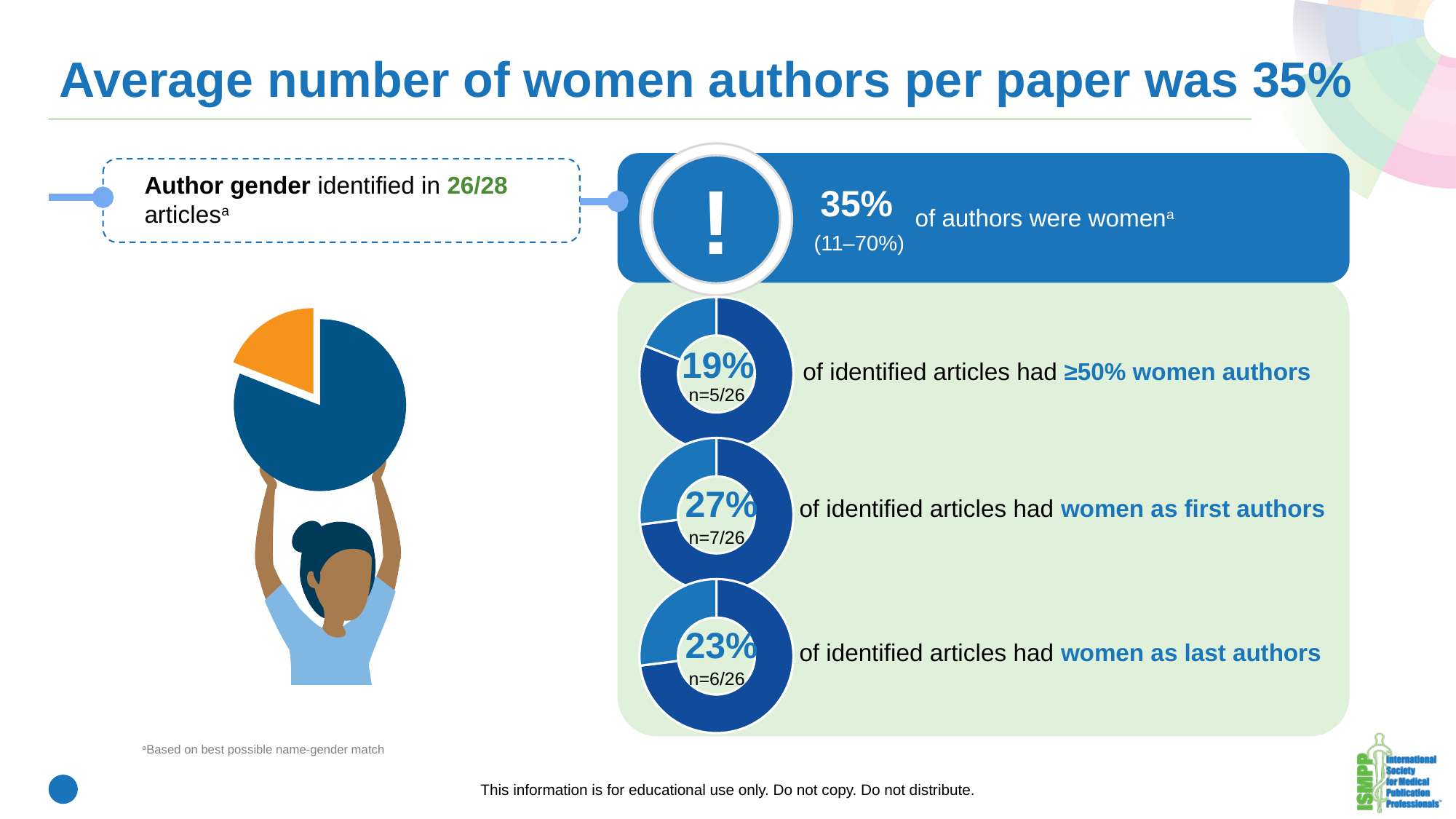
In the donut chart for women as first authors, what is the n value printed below the percentage? n=7/26 In the donut chart for ≥50% women authors, what is the n value printed below the percentage? n=5/26 What is the difference in percentage points between the women-as-first-authors donut and the ≥50%-women-authors donut? 8 percentage points In the donut chart for articles with women as last authors, what percentage is shown? 23% Which is larger: the percentage for women as first authors or the percentage for women as last authors? Women as first authors In the donut chart for articles with ≥50% women authors, what percentage is shown? 19% Among the three donut charts on the right, which category has the lowest percentage? ≥50% women authors What kind of chart is used to show the 19%, 27% and 23% values? Donut (pie) chart In the donut chart for articles with women as first authors, what percentage is shown? 27% In the donut chart for women as last authors, what is the n value printed below the percentage? n=6/26 How many donut charts are shown in the green panel on the right of the slide? 3 Among the three donut charts on the right, which category has the highest percentage? Women as first authors